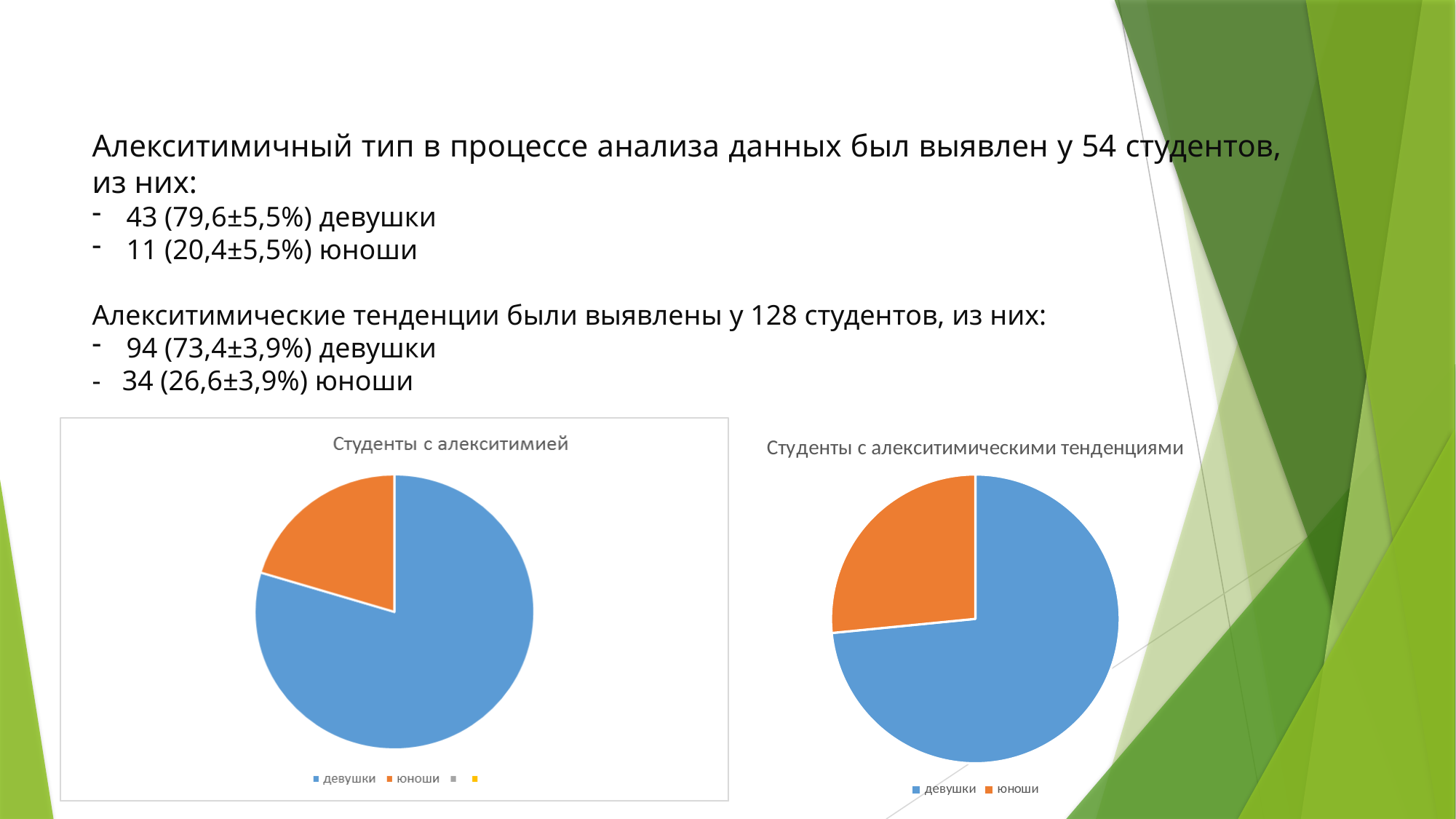
What is the title of the pie chart on the left of the slide? Студенты с алекситимией How many entries does the legend of the chart "Студенты с алекситимическими тенденциями" list? 2 In the chart "Студенты с алекситимическими тенденциями", is the slice for юноши larger or smaller than the slice for девушки? smaller What kind of chart is "Студенты с алекситимическими тенденциями"? pie chart In the chart "Студенты с алекситимией", which category has the largest slice? девушки In the chart "Студенты с алекситимией", is the slice for девушки larger or smaller than the slice for юноши? larger What kind of chart is "Студенты с алекситимией"? pie chart In the chart "Студенты с алекситимией", which category has the smallest slice? юноши How many slices does the pie chart "Студенты с алекситимическими тенденциями" have? 2 In the chart "Студенты с алекситимией", what colour is the slice for юноши? orange In the chart "Студенты с алекситимическими тенденциями", which category has the largest slice? девушки In the chart "Студенты с алекситимическими тенденциями", which category has the smallest slice? юноши